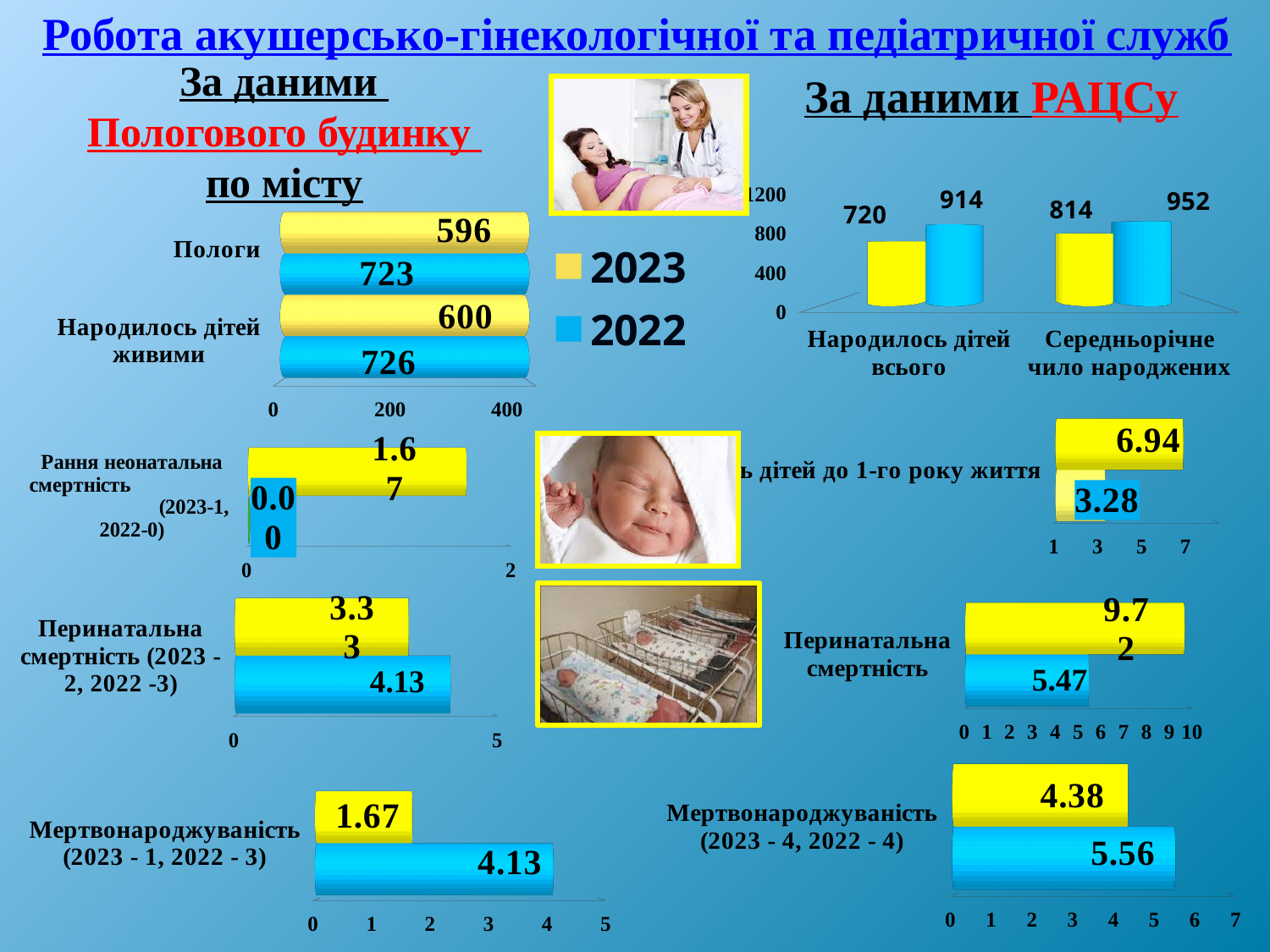
In the left chart 'Перинатальна смертність (2023 - 2, 2022 - 3)', which bar is larger, the yellow one or the blue one? the blue one (4.13) In the chart 'За даними РАЦСу', what is the blue (2022) value for Середньорічне число народжених? 952 In the chart 'Рання неонатальна смертність' on the left, what is the value of the yellow bar? 1.67 In the bottom-right chart 'Мертвонароджуваність (2023 - 4, 2022 - 4)', what is the difference between the blue and yellow bars? 1.18 In the right chart 'Перинатальна смертність', what is the value of the blue bar? 5.47 In the chart 'За даними Пологового будинку по місту', what is the value for Пологи in 2022? 723 In the chart 'За даними Пологового будинку по місту', what is the difference between the 2022 and 2023 values for Пологи? 127 In the chart 'За даними Пологового будинку по місту', what is the value for Народилось дітей живими in 2023? 600 In the chart 'За даними РАЦСу', what is the yellow (2023) value for Народилось дітей всього? 720 In the chart 'За даними РАЦСу', which of the four bars is the highest? Середньорічне число народжених, 2022 (952) In the chart 'За даними РАЦСу', is the value 720 greater or less than 800 on the axis? less How many series does the legend of the chart 'За даними Пологового будинку по місту' list? 2